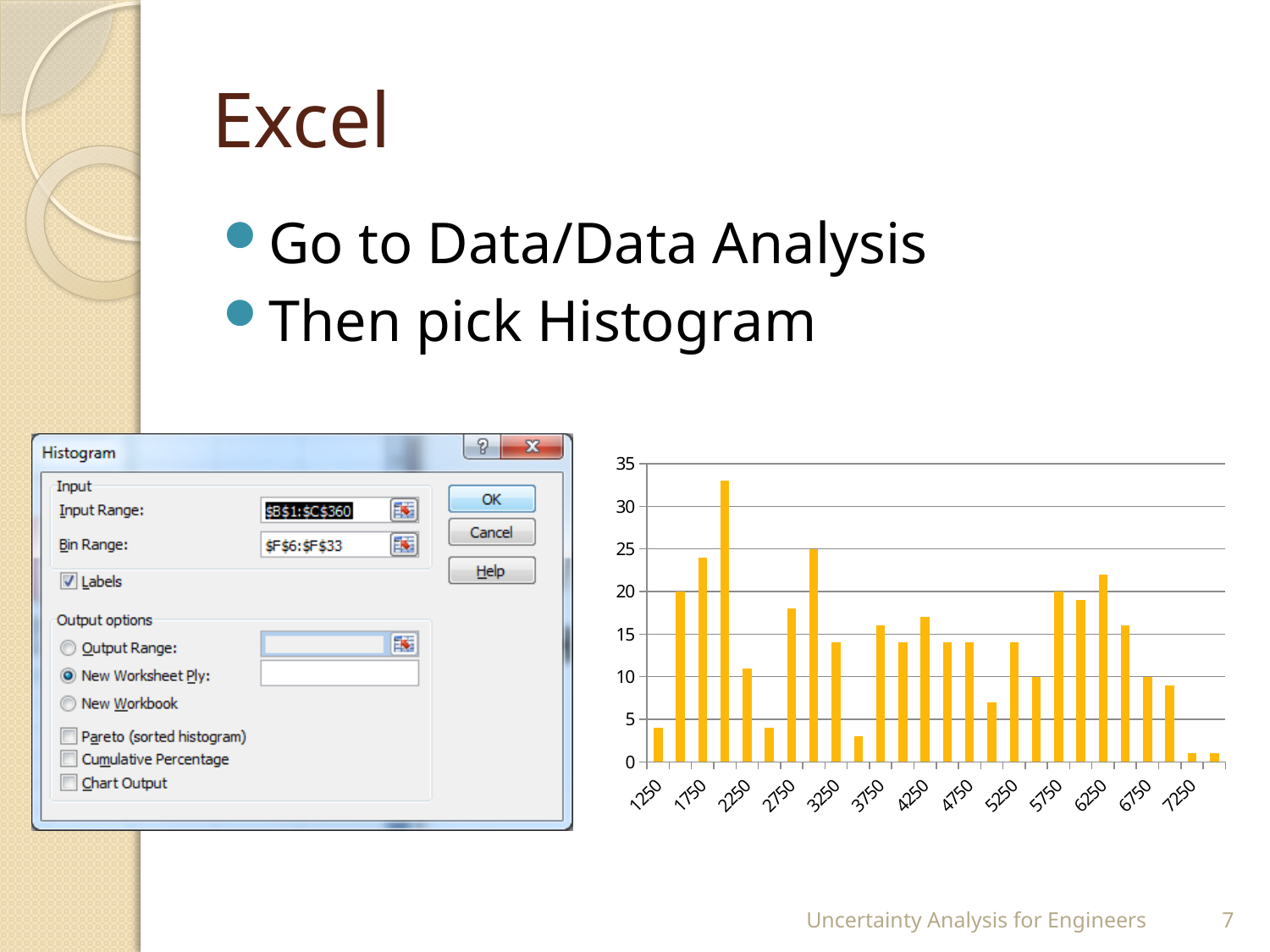
How many category labels are printed along the x axis of the chart? 13 Is the value for 6750 greater or less than 15? less Which has the larger value, 1750 or 6750? 1750 How many bars are plotted in the chart? 26 Is the value for 2750 greater or less than 15? greater What is the highest value shown on the chart's y axis? 35 Is the value for 6250 greater or less than 20? greater What kind of chart is shown on the right side of the slide? bar chart What colour are the bars in the chart? orange Which has the larger value, 2750 or 7250? 2750